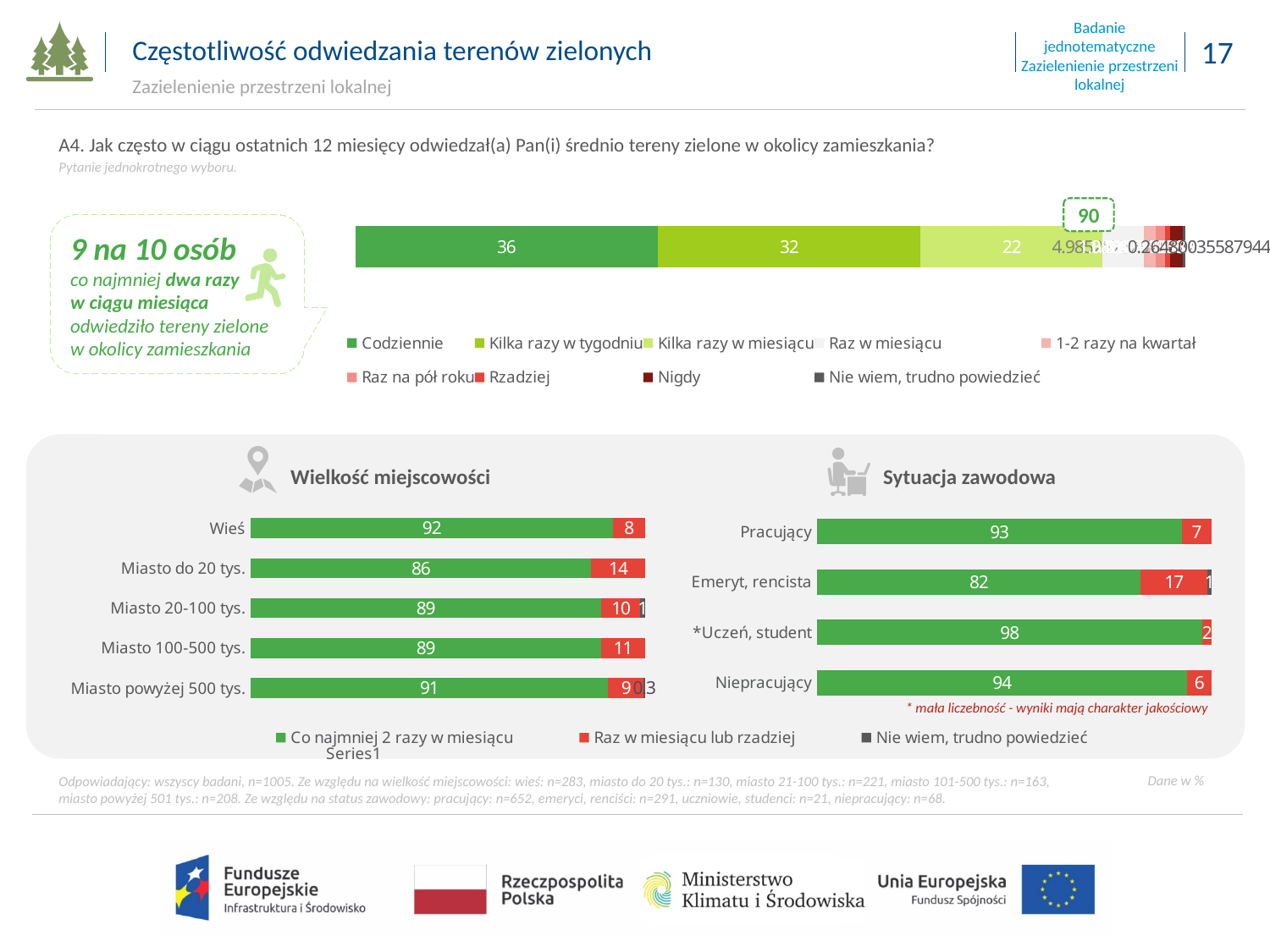
In the top stacked bar chart, which category has the highest value? Codziennie In the 'Wielkość miejscowości' chart, what is the difference between the 'Co najmniej 2 razy w miesiącu' values for 'Wieś' and 'Miasto do 20 tys.'? 6 In the 'Sytuacja zawodowa' chart, which category has the lowest 'Co najmniej 2 razy w miesiącu' value? Emeryt, rencista In the top stacked bar chart, what is the value for 'Kilka razy w tygodniu'? 32 In the 'Wielkość miejscowości' chart, what is the value of 'Co najmniej 2 razy w miesiącu' for 'Miasto do 20 tys.'? 86 In the 'Wielkość miejscowości' chart, how many categories are shown? 5 In the 'Wielkość miejscowości' chart, what is the value of 'Raz w miesiącu lub rzadziej' for 'Wieś'? 8 In the top stacked bar chart, what is the value for 'Codziennie'? 36 In the 'Sytuacja zawodowa' chart, which category has the highest 'Co najmniej 2 razy w miesiącu' value? *Uczeń, student In the 'Sytuacja zawodowa' chart, what is the value of 'Raz w miesiącu lub rzadziej' for 'Emeryt, rencista'? 17 What type of chart is the 'Sytuacja zawodowa' chart? Stacked bar chart In the top stacked bar chart, how many series does the legend list? 9